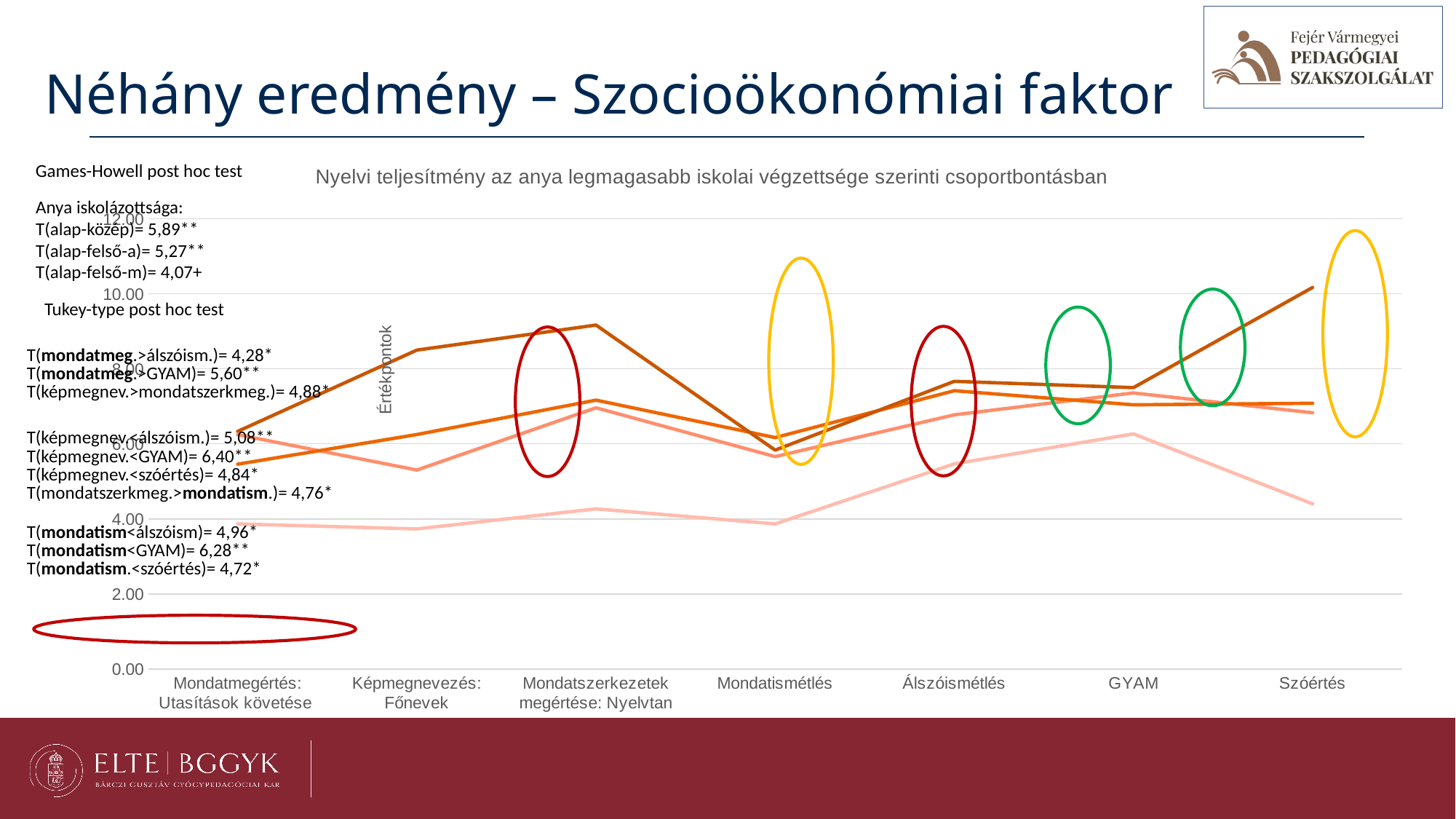
What is the label of the vertical axis of the chart? Értékpontok What kind of chart is shown on the slide? line chart Is the value of the lightest (palest) line at Szóértés greater or less than 6.00? less Does the darkest line rise or fall from GYAM to Szóértés? rise Is the value of the darkest line at Mondatismétlés greater or less than 8.00? less What is the title of the chart? Nyelvi teljesítmény az anya legmagasabb iskolai végzettsége szerinti csoportbontásban How many lines are plotted in the chart? 4 How many categories are shown on the x axis of the chart? 7 Is the value of the lightest (palest) line at Mondatismétlés greater or less than 6.00? less Does the lightest (palest) line rise or fall from GYAM to Szóértés? fall At which category does the lightest (palest) line reach its highest value? GYAM